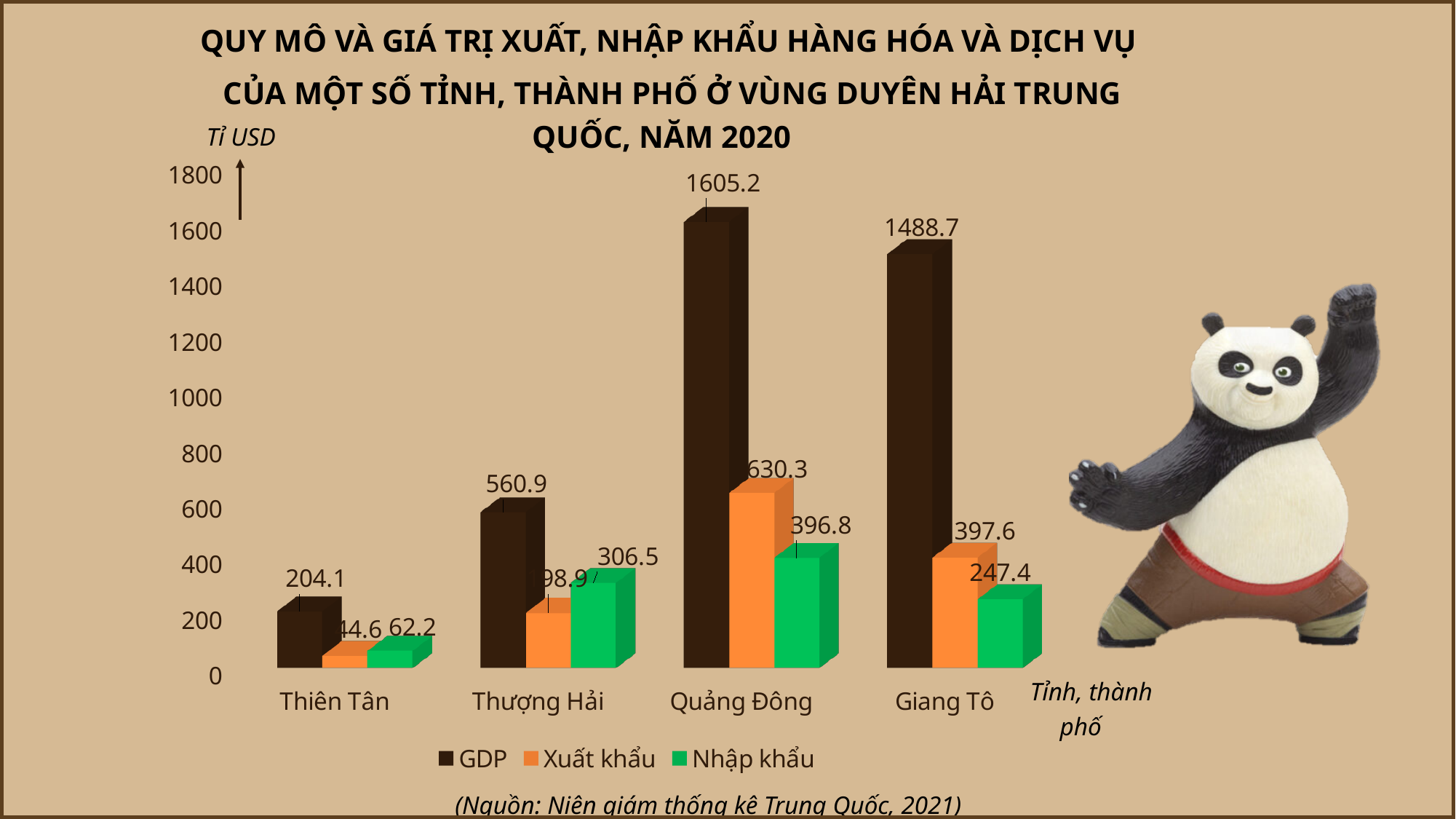
What is the Nhập khẩu value for Giang Tô? 247.4 What unit is shown on the vertical axis? Tỉ USD Is the GDP value for Thượng Hải greater or less than 600? less How many series does the legend list? 3 How many provinces or cities are shown on the x axis? 4 What kind of chart is shown on the slide? Bar chart Which province or city has the highest GDP? Quảng Đông What is the Xuất khẩu value for Thiên Tân? 44.6 What is the difference between the GDP of Quảng Đông and Giang Tô? 116.5 Which is larger: the Xuất khẩu value for Giang Tô or the Nhập khẩu value for Giang Tô? Xuất khẩu (397.6) What is the GDP value for Quảng Đông? 1605.2 Which province or city has the lowest Nhập khẩu value? Thiên Tân